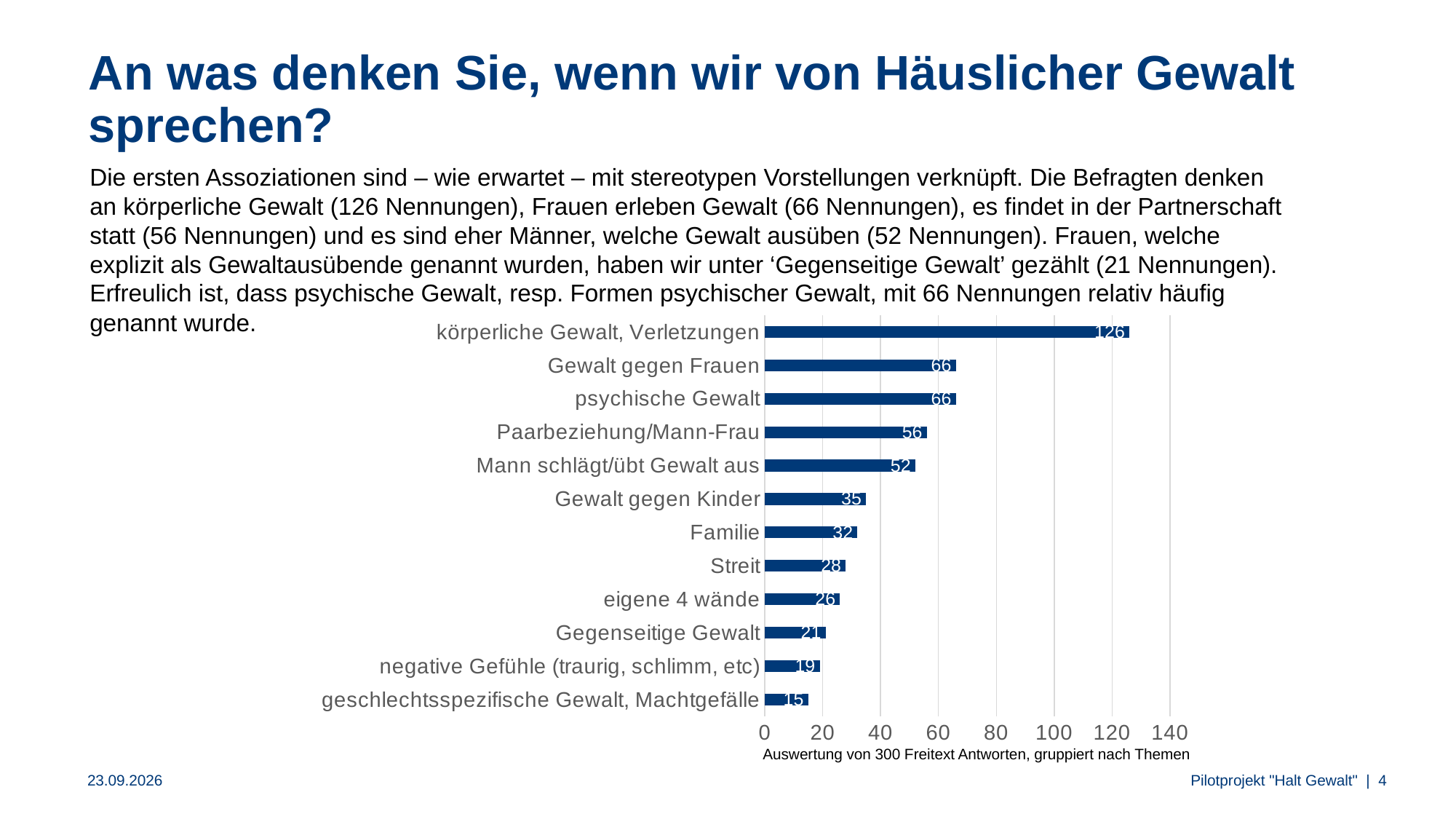
Which is larger, the value for "Paarbeziehung/Mann-Frau" or for "Mann schlägt/übt Gewalt aus"? Paarbeziehung/Mann-Frau Which category has the highest value? körperliche Gewalt, Verletzungen How many categories does the chart show? 12 Which category has the lowest value? geschlechtsspezifische Gewalt, Machtgefälle What is the value for "Gewalt gegen Kinder"? 35 What kind of chart is shown on the slide? bar chart What is the value for "körperliche Gewalt, Verletzungen"? 126 Is the value for "eigene 4 wände" greater or less than 40? less What is the difference between the values for "körperliche Gewalt, Verletzungen" and "Gewalt gegen Frauen"? 60 What is the value for "Gegenseitige Gewalt"? 21 What is the difference between the values for "Familie" and "Streit"? 4 What is the text shown below the x axis of the chart? Auswertung von 300 Freitext Antworten, gruppiert nach Themen